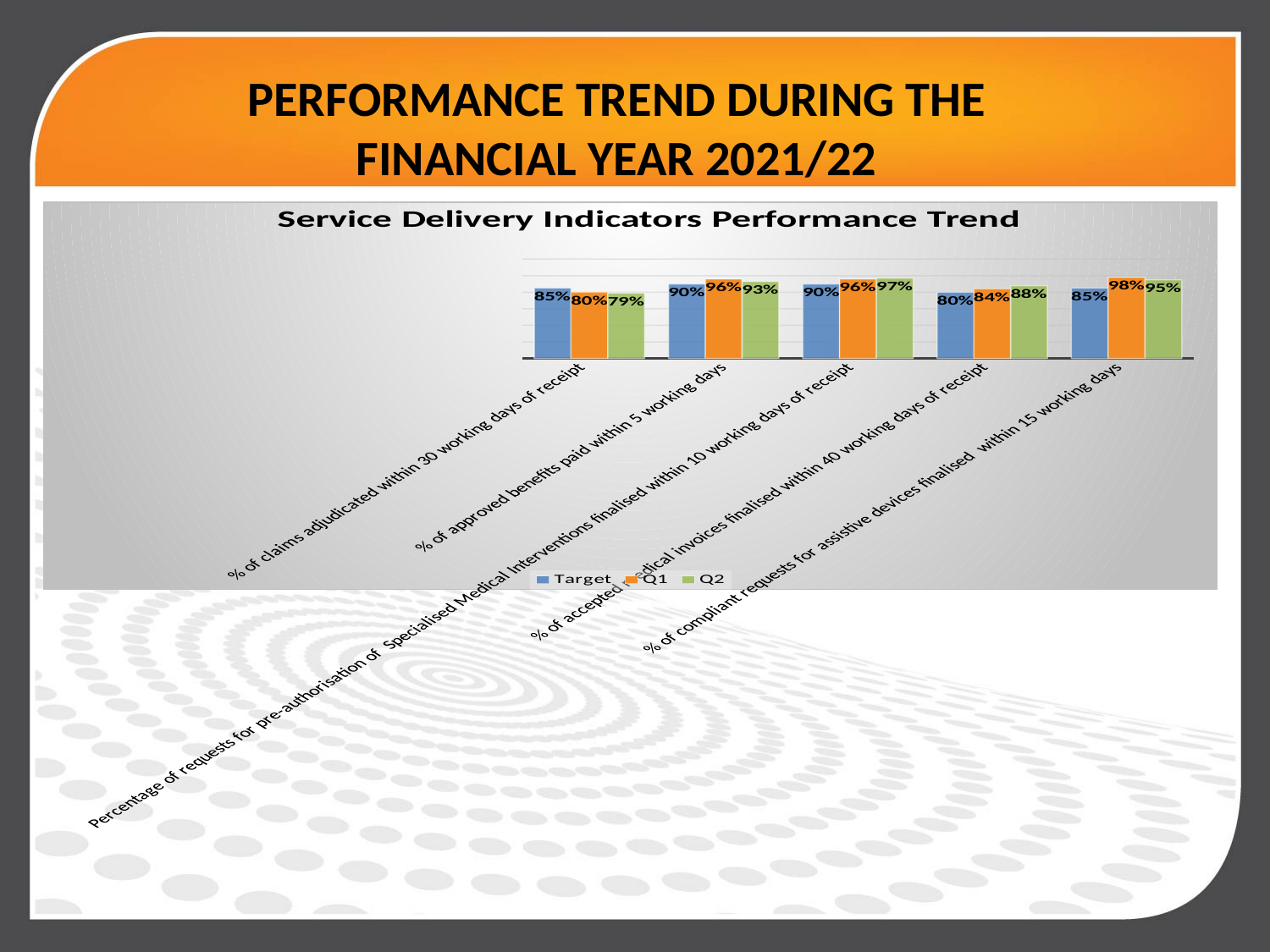
What is the Q1 value for '% of approved benefits paid within 5 working days'? 96% Which category has the highest Q1 value? % of compliant requests for assistive devices finalised within 15 working days How many series does the legend list? 3 What is the Target value for '% of claims adjudicated within 30 working days of receipt'? 85% What is the difference between the Q1 and Target values for '% of compliant requests for assistive devices finalised within 15 working days'? 13% How many categories are shown on the x axis? 5 Which category has the lowest Q2 value? % of claims adjudicated within 30 working days of receipt For '% of claims adjudicated within 30 working days of receipt', is the Q1 value higher or lower than the Target value? lower What type of chart is shown? bar chart What is the title of the chart? Service Delivery Indicators Performance Trend What is the Q2 value for '% of compliant requests for assistive devices finalised within 15 working days'? 95%